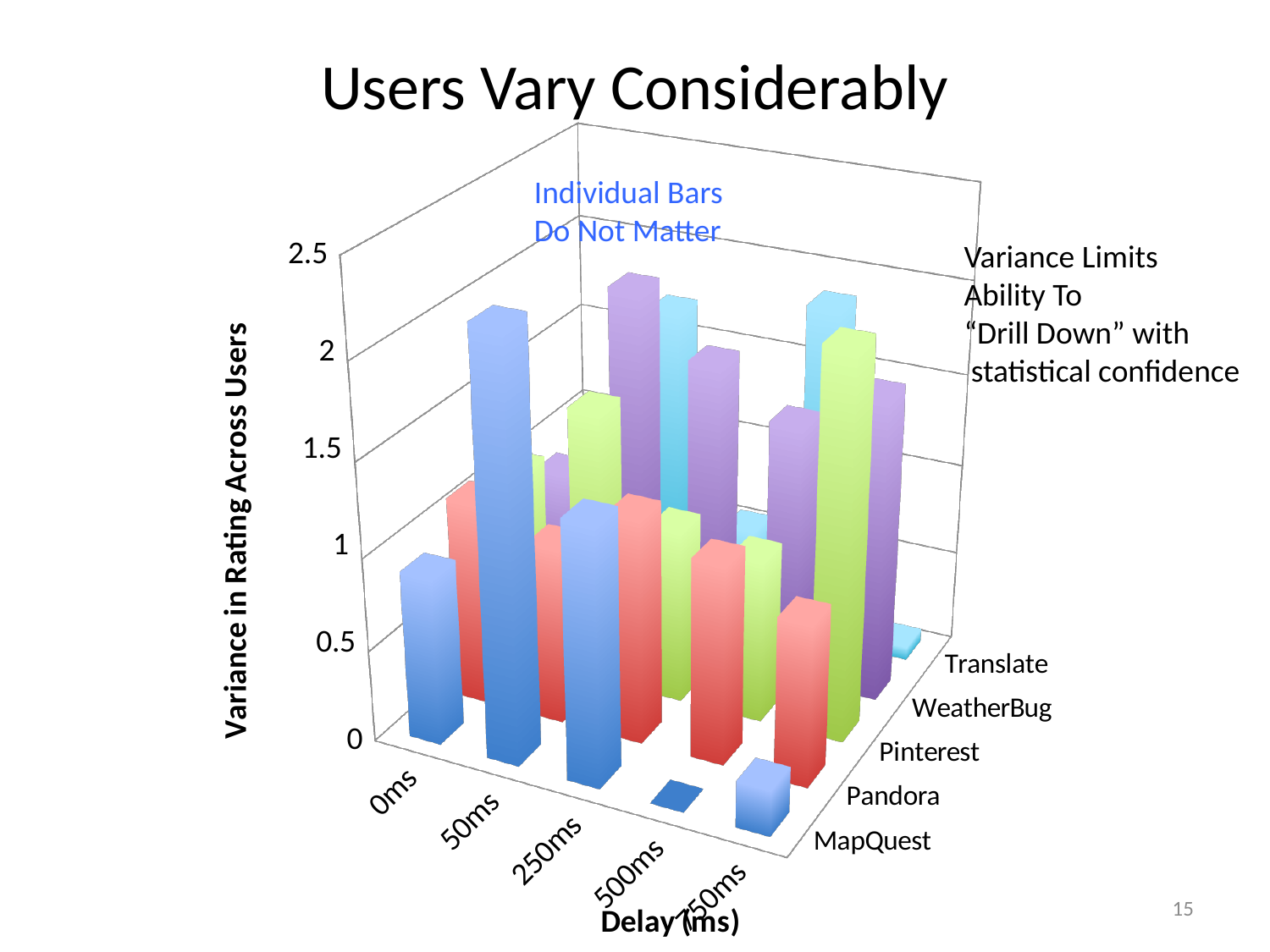
For MapQuest, is the bar at 50ms or at 0ms taller? 50ms Is the value for MapQuest at 500ms greater or less than 0.5? less Is the value for Translate at 750ms greater or less than 0.5? less Which delay category has the tallest bar for MapQuest? 50ms Is the value for MapQuest at 50ms greater or less than 1.5? greater What kind of chart is shown on the slide? bar chart What is the label of the vertical axis? Variance in Rating Across Users Which delay category has the lowest bar for MapQuest? 500ms What is the title of the chart on the slide? Users Vary Considerably How many delay categories are shown along the Delay (ms) axis? 5 What is the highest tick value shown on the vertical axis? 2.5 How many applications (series) are plotted in the chart? 5